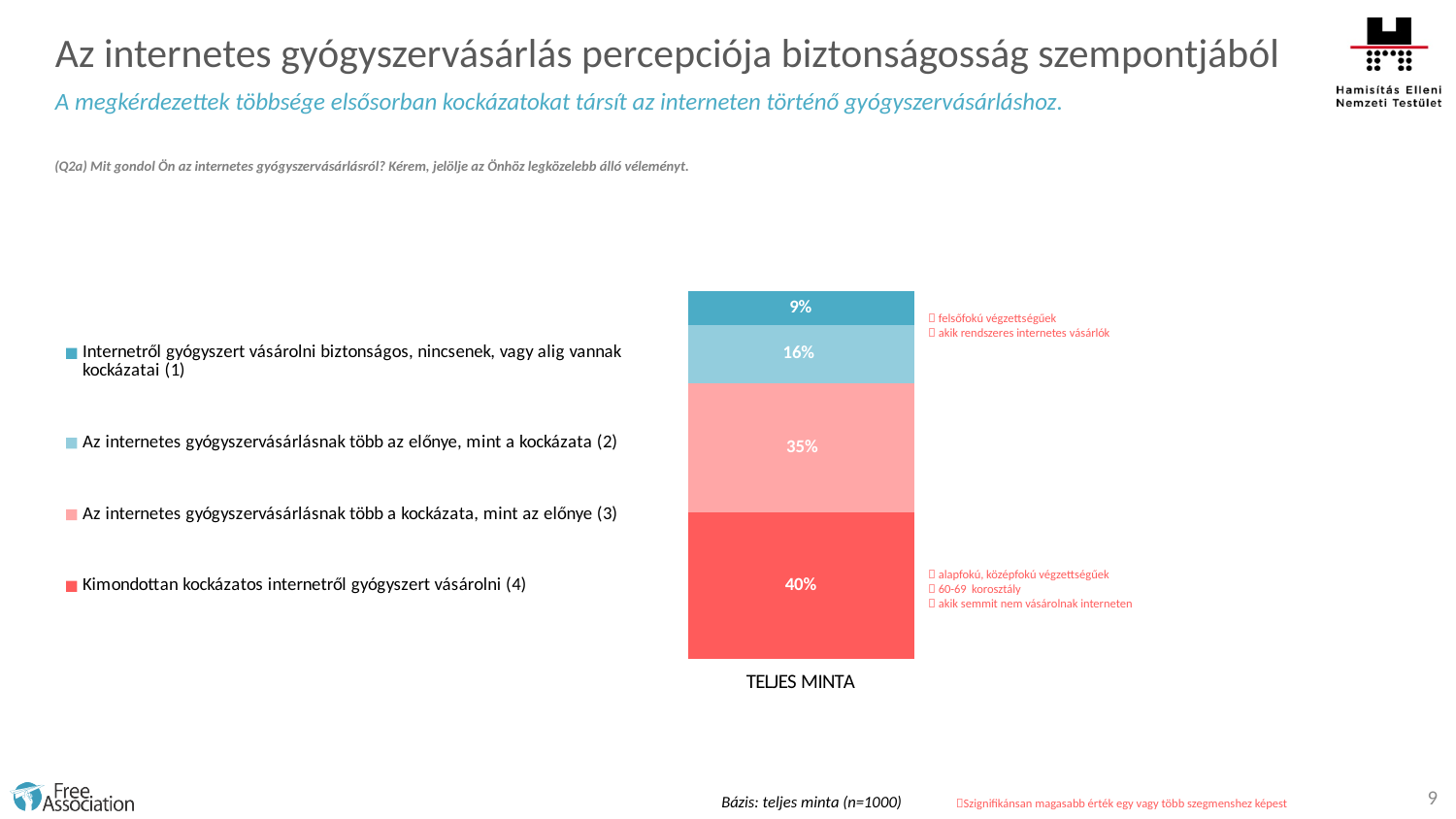
What kind of chart is shown on the slide? Stacked bar chart What percentage of respondents chose "Kimondottan kockázatos internetről gyógyszert vásárolni (4)"? 40% Which response option has the smallest share in the stacked bar? Internetről gyógyszert vásárolni biztonságos, nincsenek, vagy alig vannak kockázatai (1) What is the value for "Az internetes gyógyszervásárlásnak több az előnye, mint a kockázata (2)"? 16% Which is larger: the share for option (2) or the share for option (3)? Option (3), 35% What is the difference between the share for option (2) and the share for option (1)? 7% What is the value for "Az internetes gyógyszervásárlásnak több a kockázata, mint az előnye (3)"? 35% Which response option has the largest share in the stacked bar? Kimondottan kockázatos internetről gyógyszert vásárolni (4) What is the label of the category shown under the stacked bar? TELJES MINTA What is the difference between the share for option (4) and the share for option (3)? 5% What is the value for "Internetről gyógyszert vásárolni biztonságos, nincsenek, vagy alig vannak kockázatai (1)"? 9% How many series does the legend list? 4